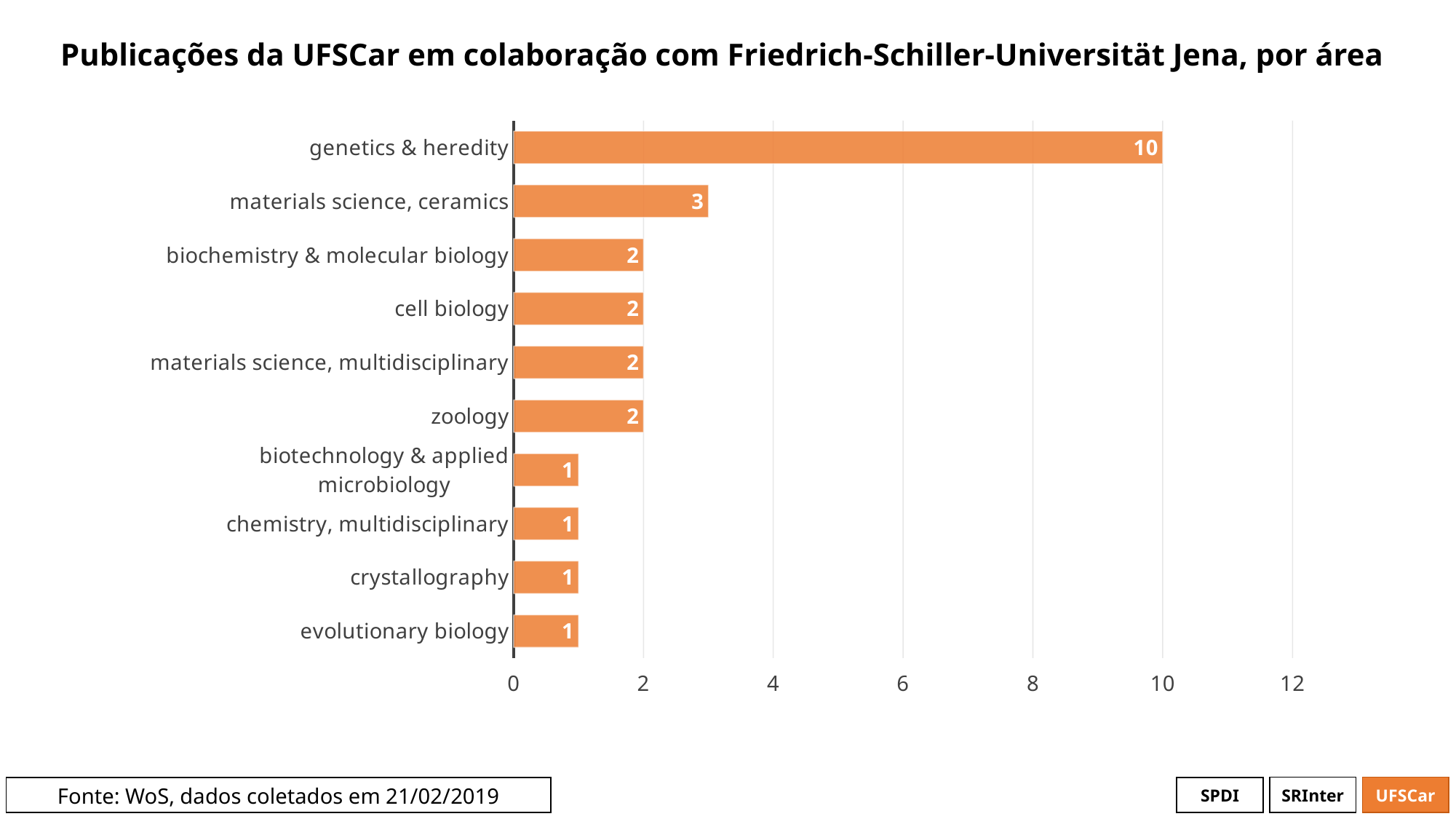
Is the value for genetics & heredity greater or less than 8? greater What is the value for zoology? 2 Which category has the highest value? genetics & heredity What is the title of the chart? Publicações da UFSCar em colaboração com Friedrich-Schiller-Universität Jena, por área What is the difference between the values for cell biology and evolutionary biology? 1 What is the difference between the values for genetics & heredity and materials science, ceramics? 7 What is the value for genetics & heredity? 10 How many categories are shown in the chart? 10 What is the value for crystallography? 1 What kind of chart is shown on the slide? bar chart Which is larger, the value for materials science, ceramics or the value for biochemistry & molecular biology? materials science, ceramics What is the value for materials science, ceramics? 3